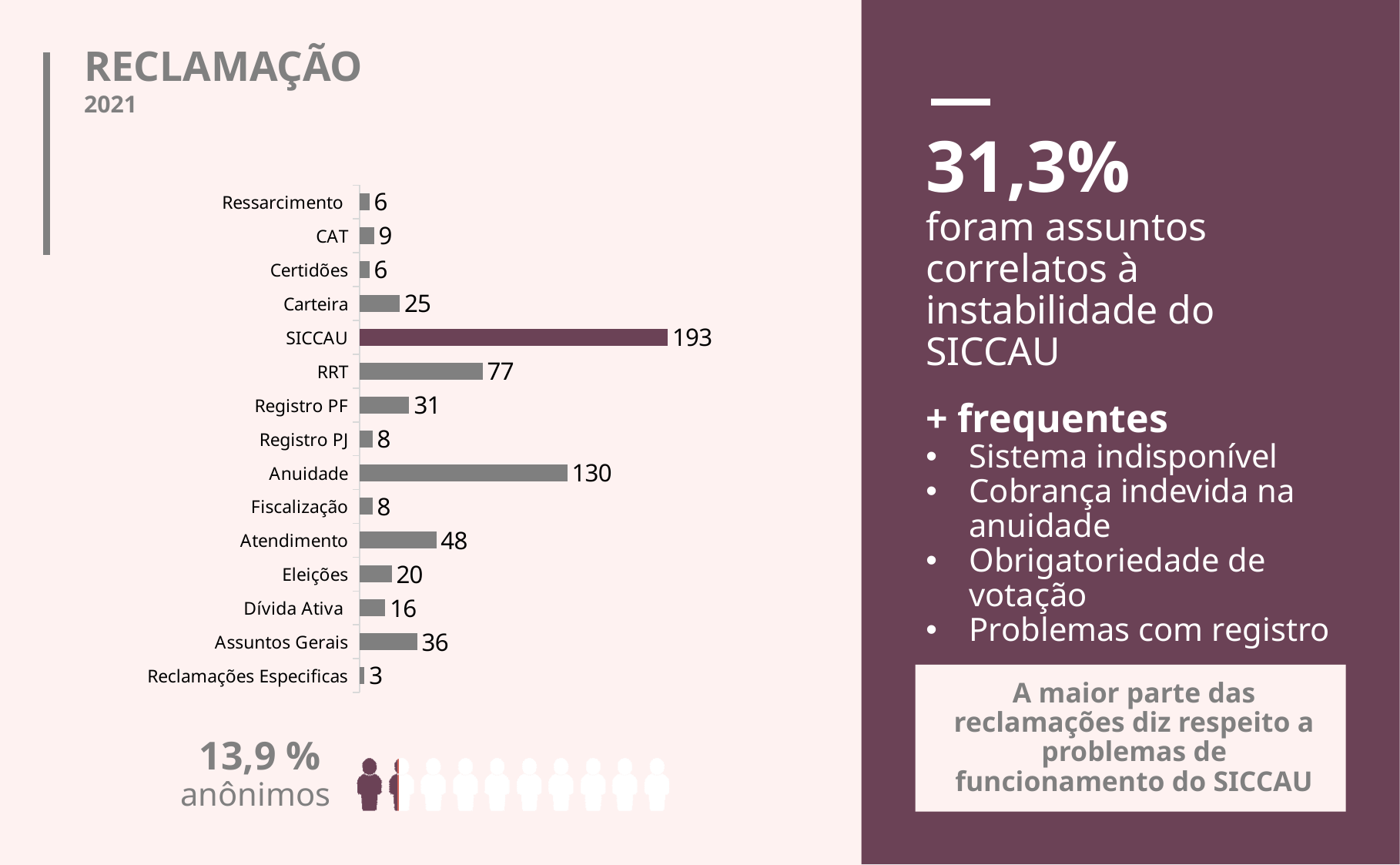
Which is larger, the value for Carteira or the value for Assuntos Gerais? Assuntos Gerais What is the difference between the values for RRT and Registro PF? 46 What kind of chart is shown on the slide? Bar chart What is the value for Anuidade in the bar chart? 130 What is the value for SICCAU in the bar chart? 193 What is the difference between the values for SICCAU and Anuidade? 63 How many categories are shown in the bar chart? 15 What is the value for Atendimento in the bar chart? 48 Which category has the highest value in the bar chart? SICCAU Which category has the lowest value in the bar chart? Reclamações Especificas Which bar in the chart is coloured differently from the others? SICCAU Which is larger, the value for Eleições or the value for Dívida Ativa? Eleições